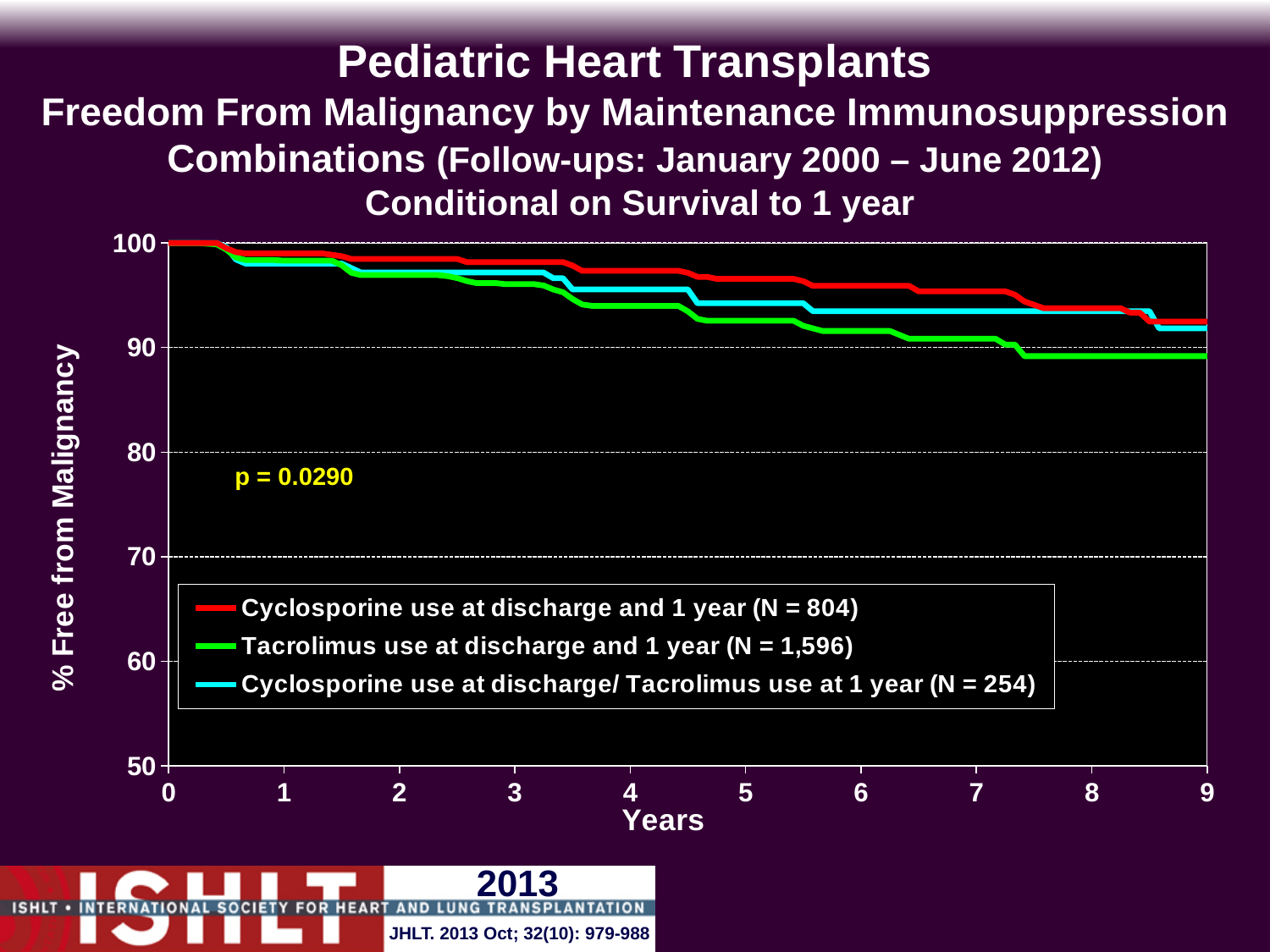
Is the value for Tacrolimus use at discharge and 1 year at year 9 greater or less than 80? greater Which series has the highest % free from malignancy at year 9? Cyclosporine use at discharge and 1 year Do the % free from malignancy values rise or fall as years increase? Fall How many series does the legend list? 3 At year 7, which is higher: the Cyclosporine use at discharge and 1 year series or the Tacrolimus use at discharge and 1 year series? Cyclosporine use at discharge and 1 year Is the value for Cyclosporine use at discharge and 1 year at year 5 greater or less than 90? greater Is the value for Tacrolimus use at discharge and 1 year at year 3 greater or less than 90? greater What p-value is printed on the chart? p = 0.0290 What kind of chart is shown on the slide? Line chart According to the legend, what is the N for the Tacrolimus use at discharge and 1 year group? 1,596 Which series has the lowest % free from malignancy at year 9? Tacrolimus use at discharge and 1 year